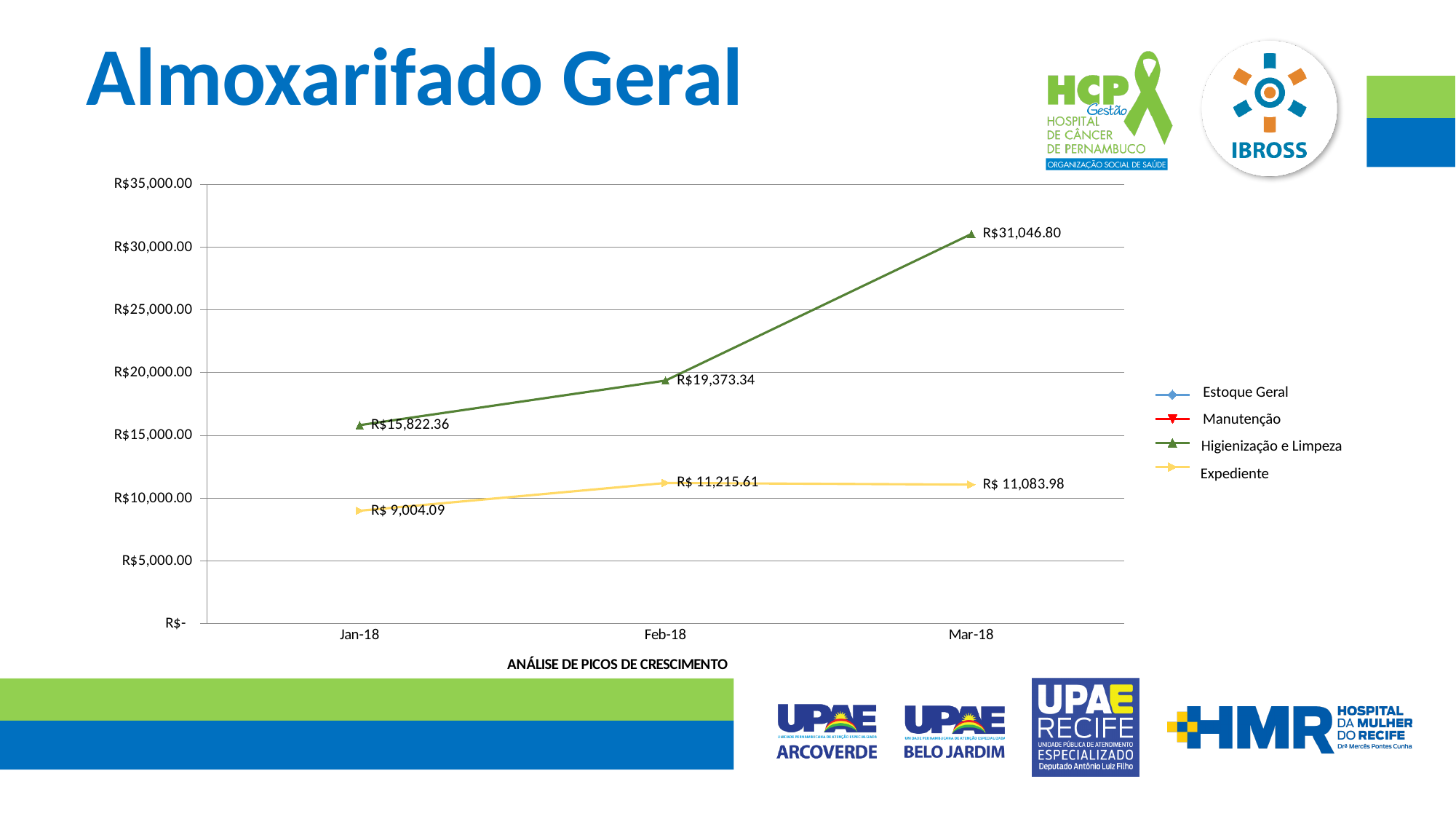
What kind of chart is shown on the slide? line chart How many series does the legend list? 4 What is the difference between the Higienização e Limpeza values for Mar-18 and Jan-18? R$15,224.44 What is the value for Higienização e Limpeza in Feb-18? R$19,373.34 In which month is Higienização e Limpeza highest? Mar-18 What is the value for Higienização e Limpeza in Mar-18? R$31,046.80 Is the value for Higienização e Limpeza in Mar-18 greater or less than R$30,000.00? greater Which is larger in Feb-18: Higienização e Limpeza or Expediente? Higienização e Limpeza What is the value for Expediente in Jan-18? R$ 9,004.09 In which month is Expediente lowest? Jan-18 How many months are shown on the x axis? 3 What is the value for Expediente in Mar-18? R$ 11,083.98